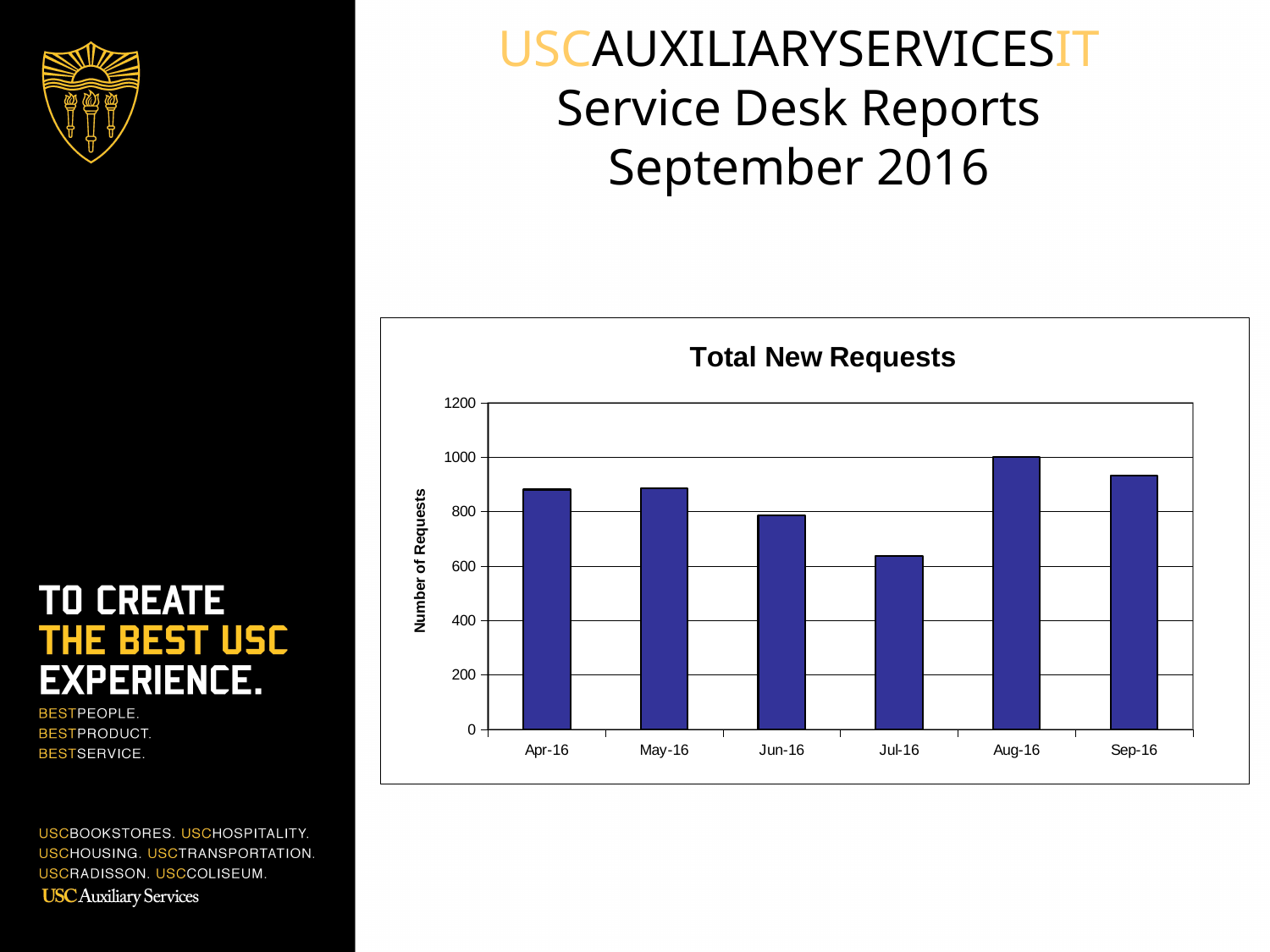
Which is larger, the value for Aug-16 or the value for Jul-16? Aug-16 What is the label on the vertical axis of the chart? Number of Requests What kind of chart is shown on the slide? bar chart Is the value for Sep-16 greater or less than 1000? less Is the value for Jul-16 greater or less than 800? less How many months are shown on the x axis of the chart? 6 What is the title of the chart? Total New Requests Which is larger, the value for Sep-16 or the value for Jun-16? Sep-16 Which month has the lowest number of new requests? Jul-16 Is the value for Jul-16 greater or less than 600? greater Which month has the highest number of new requests? Aug-16